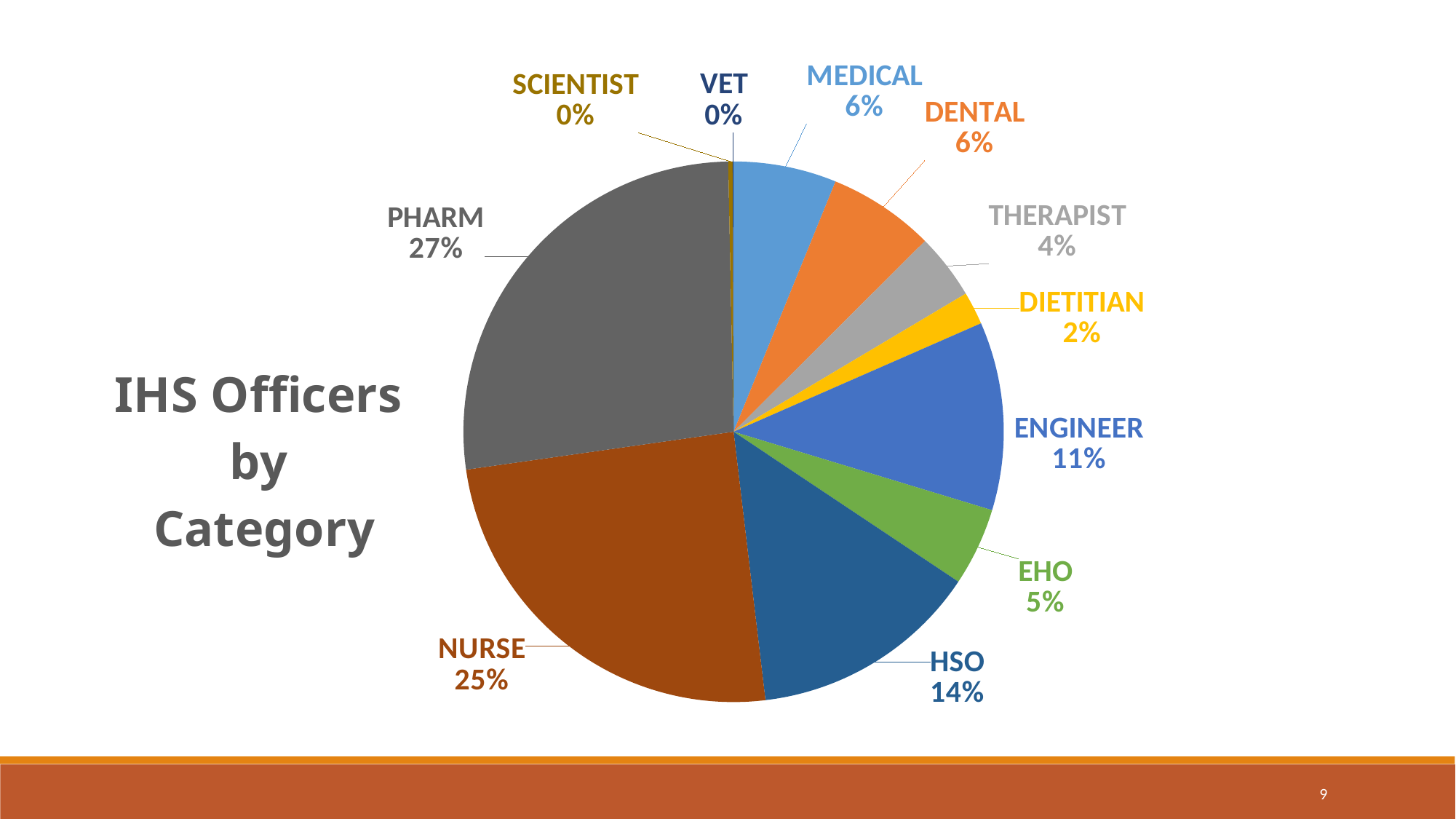
What is the title of the chart? IHS Officers by Category What is the difference in percentage points between the PHARM and NURSE shares? 2 What colour is the NURSE slice? brown What is the difference in percentage points between the HSO and EHO shares? 9 What percentage of IHS officers are in the HSO category? 14% What percentage of IHS officers are in the ENGINEER category? 11% How many categories are labelled on the pie chart? 11 What percentage of IHS officers are in the PHARM category? 27% Which category has the largest share of IHS officers? PHARM What kind of chart is shown on the slide? pie chart What percentage of IHS officers are in the DIETITIAN category? 2% Which is larger, the ENGINEER share or the THERAPIST share? ENGINEER